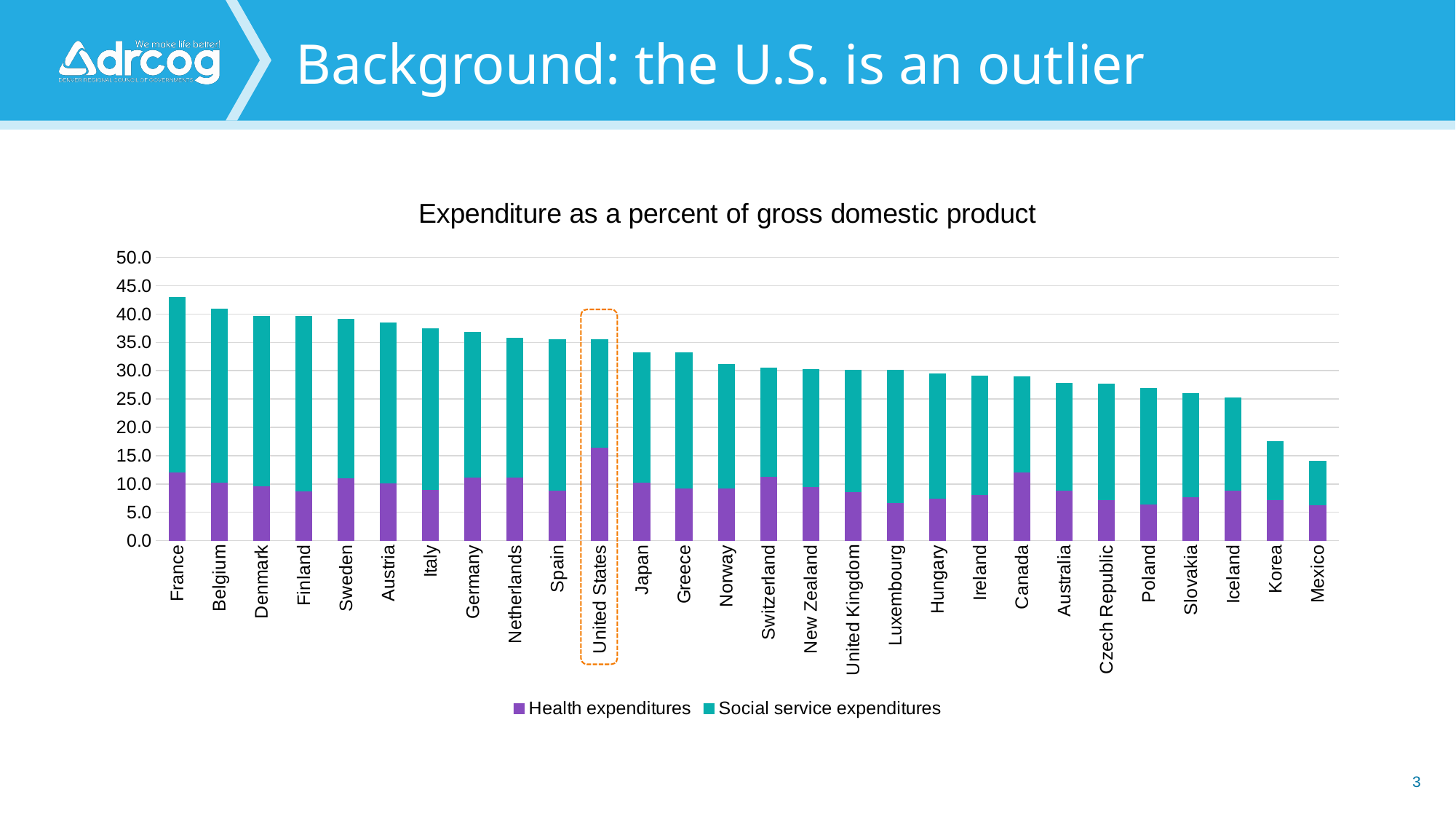
Is the health expenditures value for the United States greater or less than 15.0? greater Which country has larger health expenditures as a percent of GDP, the United States or France? United States Which country has the lowest total expenditure as a percent of GDP? Mexico What kind of chart is shown on the slide? stacked bar chart How many series does the chart legend list? 2 Do the total expenditure values rise or fall moving from left to right along the x axis? fall Which country has the highest total expenditure as a percent of GDP? France Is the total expenditure for Japan greater or less than 35.0? less Is the total expenditure for France greater or less than 40.0? greater How many countries are shown on the x axis of the chart? 28 Which country is highlighted with a dashed outline on the chart? United States Which country has the highest health expenditures as a percent of GDP? United States